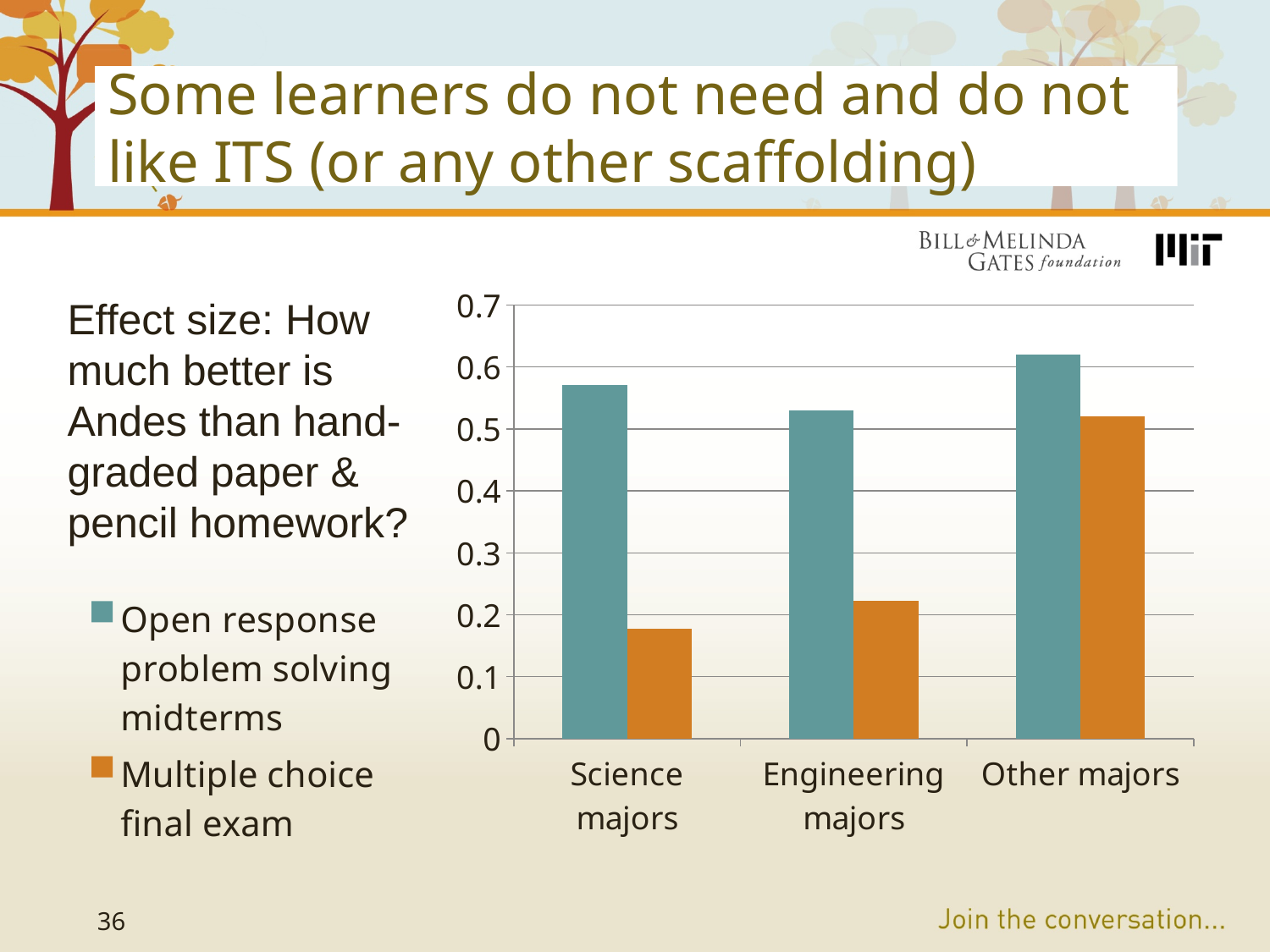
Is the value for Open response problem solving midterms for Other majors greater or less than 0.6? greater Which colour represents the Multiple choice final exam series in the chart? orange How many categories are shown on the x axis of the chart? 3 Is the value for Open response problem solving midterms for Engineering majors greater or less than 0.5? greater Which category has the lowest value for Open response problem solving midterms? Engineering majors For Science majors, which is larger: Open response problem solving midterms or Multiple choice final exam? Open response problem solving midterms How many series does the chart's legend list? 2 Which category has the highest value for Multiple choice final exam? Other majors Is the value for Multiple choice final exam for Other majors greater or less than 0.5? greater Which category has the lowest value for Multiple choice final exam? Science majors What kind of chart is shown on the slide? bar chart